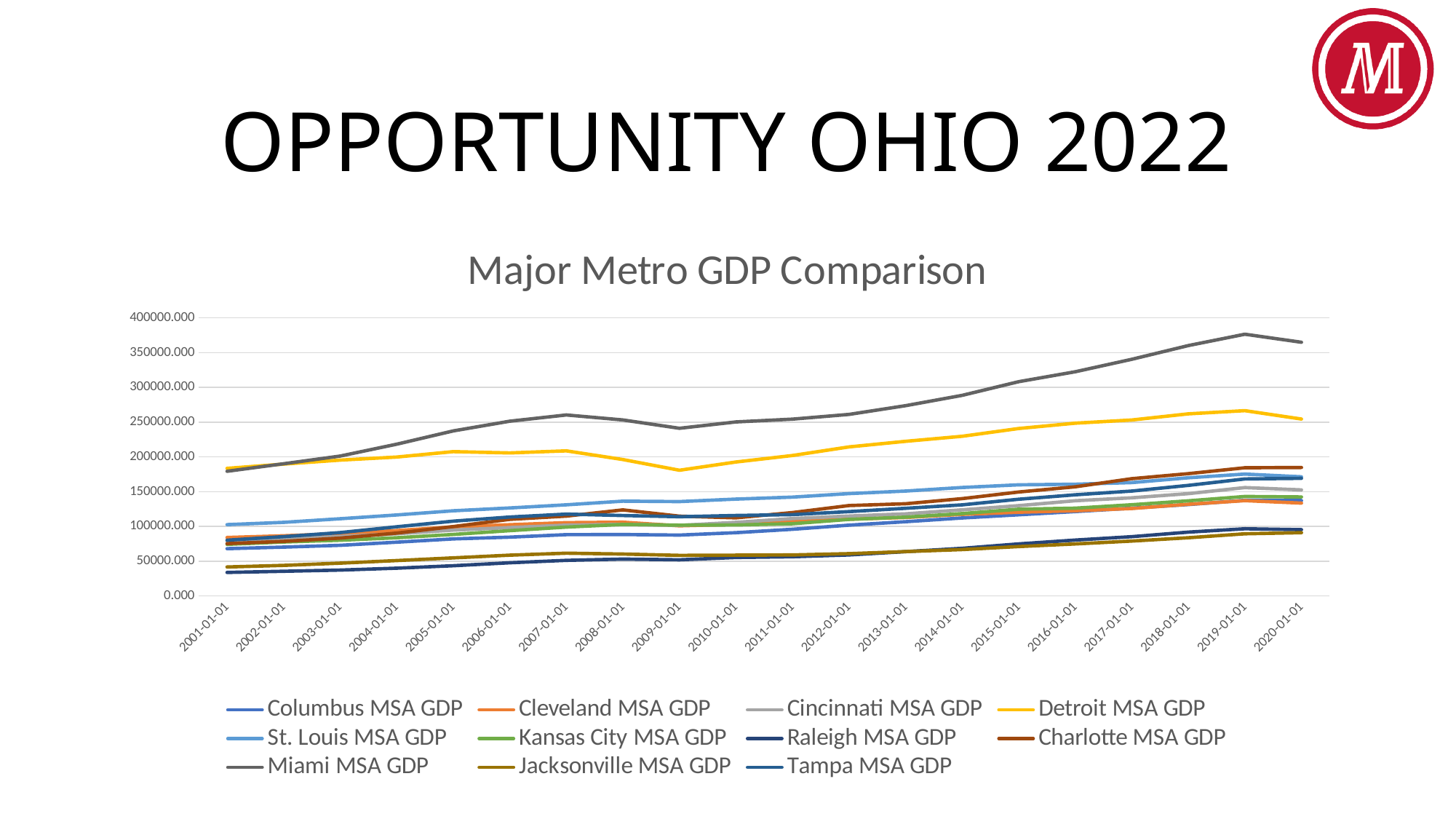
What is the title of the chart? Major Metro GDP Comparison Is the value for Detroit MSA GDP at 2009-01-01 greater or less than 200000? less Which is larger at 2020-01-01, Miami MSA GDP or Detroit MSA GDP? Miami MSA GDP What kind of chart is shown on the slide? line chart How many dates are shown along the x axis of the chart? 20 Which series has the highest GDP value in 2019-01-01? Miami MSA GDP Which series has the lowest GDP value in 2001-01-01? Raleigh MSA GDP Does the Miami MSA GDP line generally rise or fall from 2001-01-01 to 2019-01-01? rise How many series does the legend of the Major Metro GDP Comparison chart list? 11 Is the value for Raleigh MSA GDP at 2001-01-01 greater or less than 50000? less Is the value for Miami MSA GDP at 2019-01-01 greater or less than 350000? greater